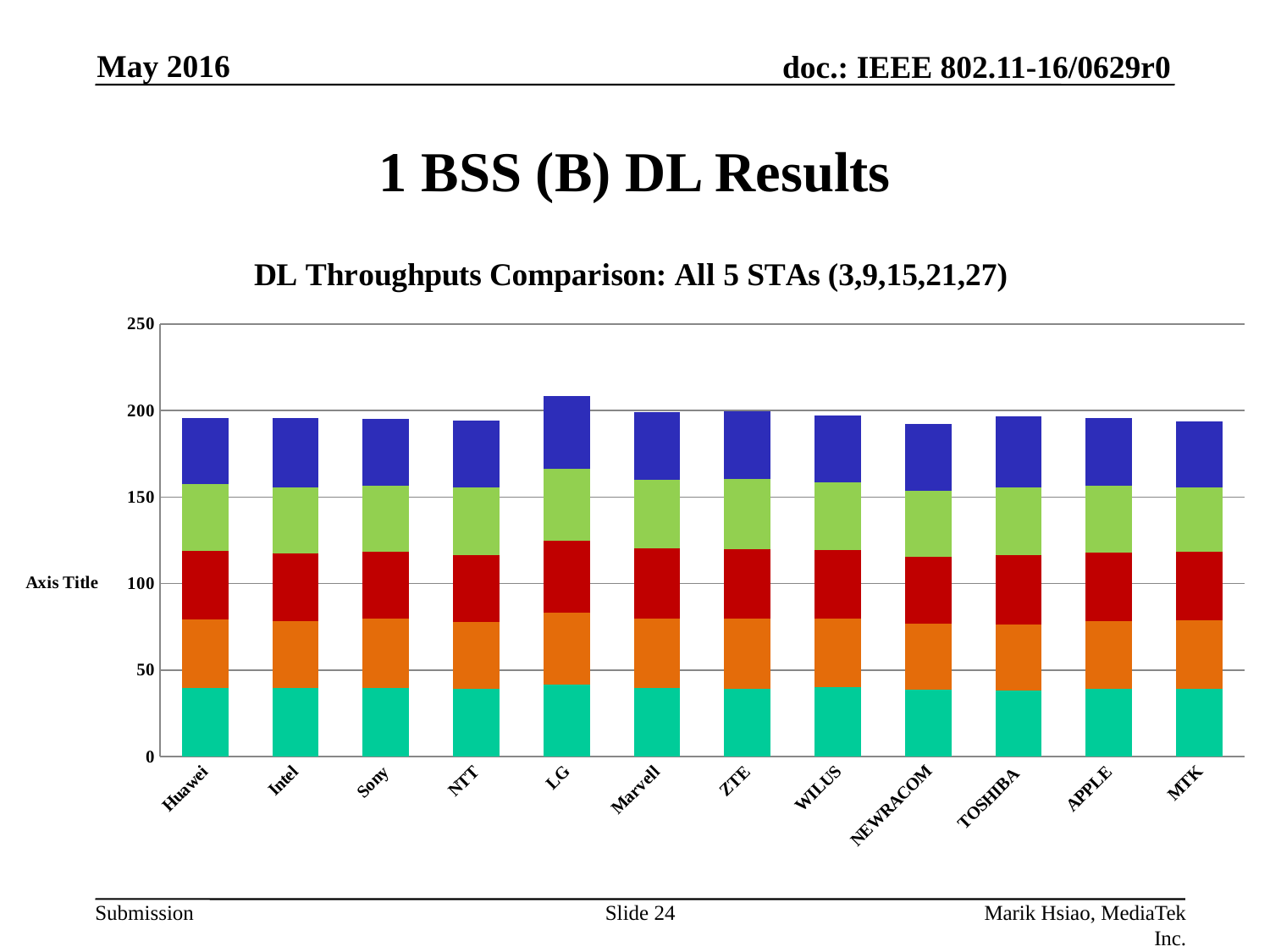
Which has the taller stacked bar, LG or NEWRACOM? LG Which has the taller stacked bar, LG or Huawei? LG How many stacked segments make up each bar in the chart? 5 What kind of chart is shown on the slide? stacked bar chart What is the label shown on the vertical axis of the chart? Axis Title Which company has the tallest stacked bar in the chart? LG What is the title of the chart? DL Throughputs Comparison: All 5 STAs (3,9,15,21,27) Is the total stacked value for Intel greater or less than 150? greater Is the total stacked value for NEWRACOM greater or less than 200? less How many companies are shown on the x axis of the chart? 12 Is the total stacked value for Huawei greater or less than 200? less